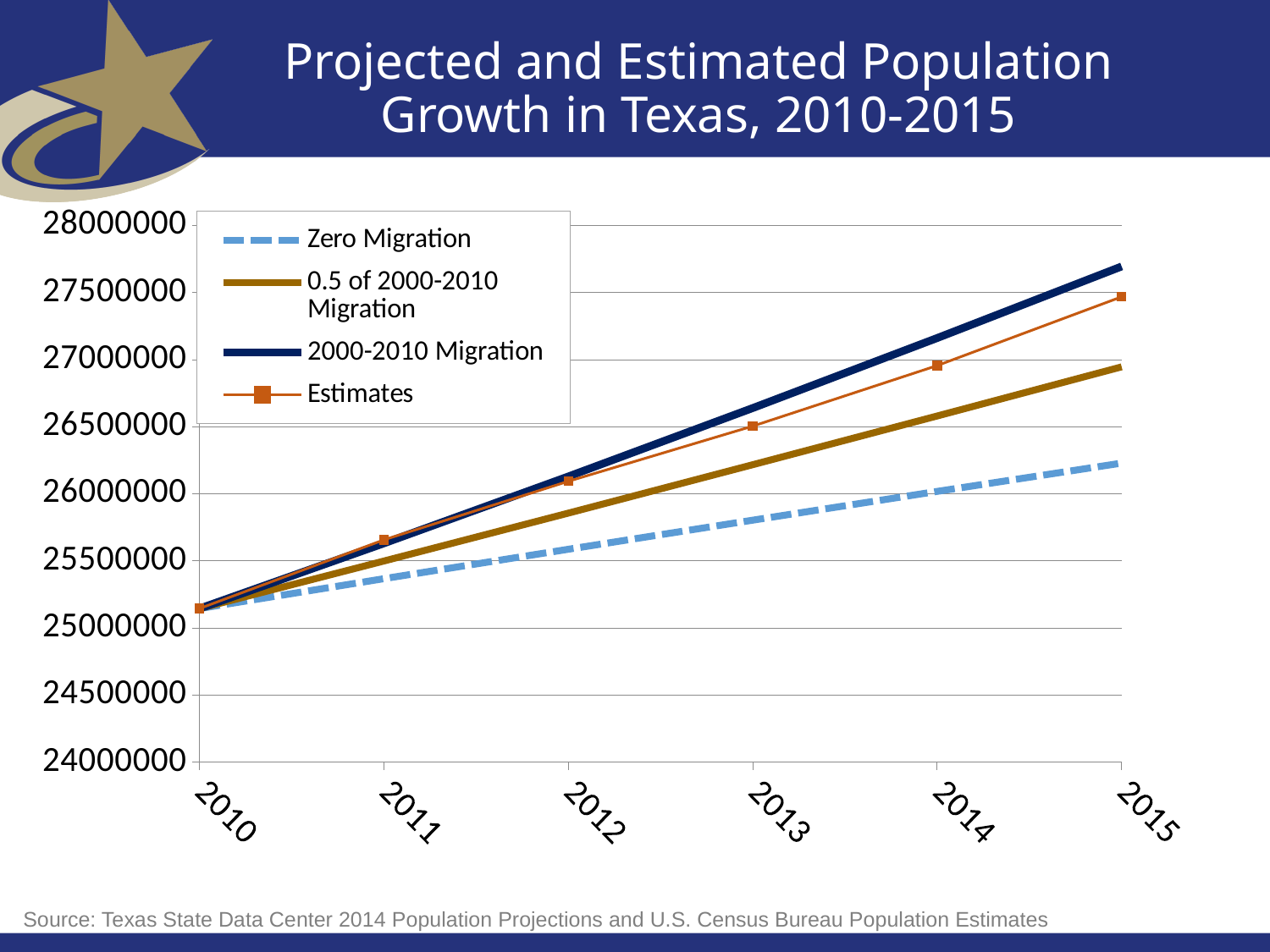
Is the value for Zero Migration in 2015 greater or less than 26000000? greater Do the values for the Estimates series rise or fall from 2010 to 2015? Rise Is the value for 2000-2010 Migration in 2015 greater or less than 27500000? greater Which series is drawn with a dashed line? Zero Migration In 2014, which is larger: the Estimates value or the 0.5 of 2000-2010 Migration projection? Estimates How many series does the legend list? 4 What kind of chart is shown on the slide? Line chart How many years are shown along the x axis? 6 In 2015, which is larger: the 2000-2010 Migration projection or the Estimates value? 2000-2010 Migration Which series has the lowest value in 2015? Zero Migration Which series has the highest value in 2015? 2000-2010 Migration